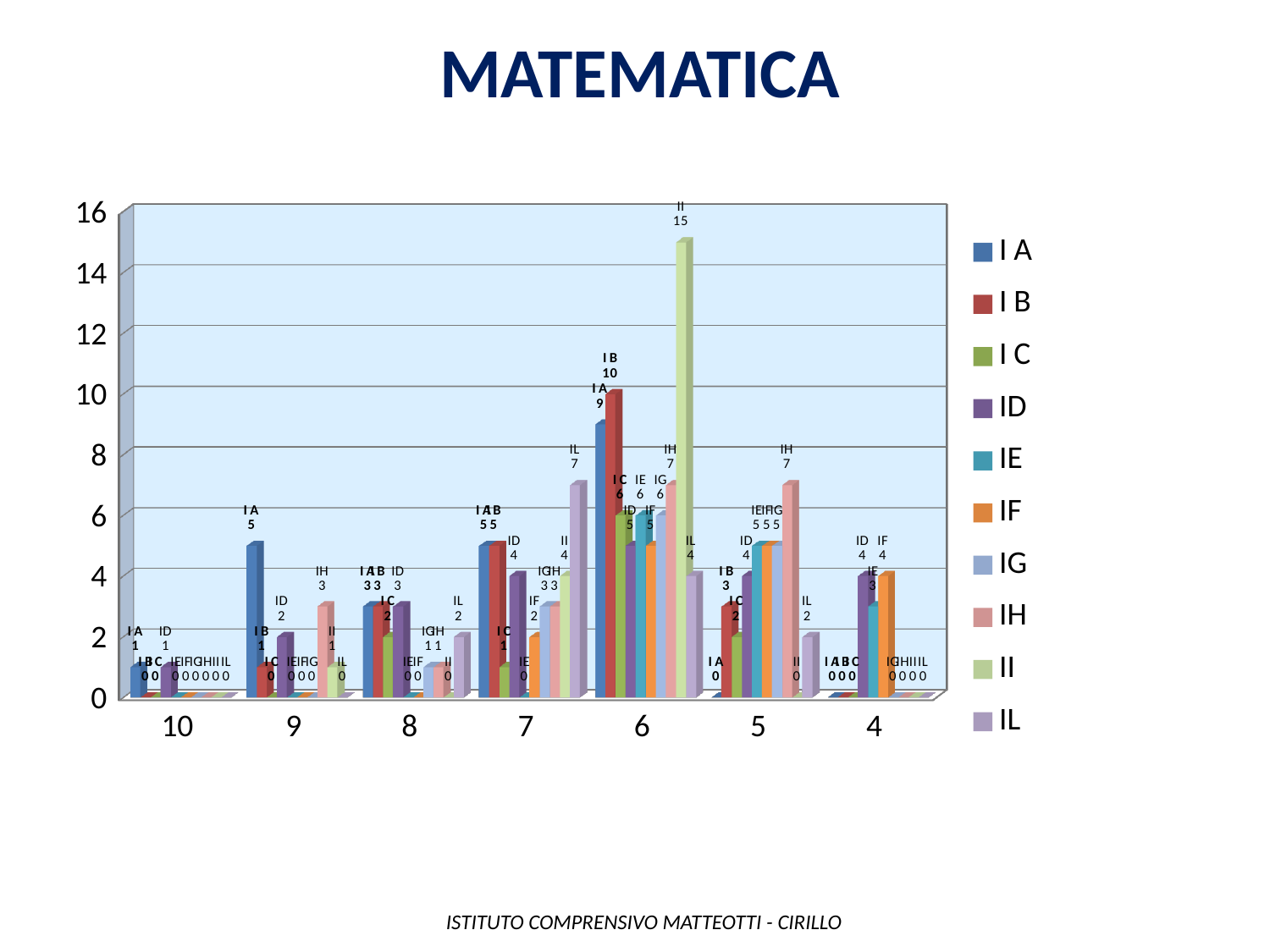
What kind of chart is shown on the slide? bar chart What is the value for series I A in category 9? 5 What is the difference between the values of I B and I A in category 6? 1 What is the value for series I B in category 6? 10 What is the value for series IH in category 5? 7 Is the value for series II in category 6 greater or less than 14? greater What is the value for series II in category 6? 15 How many categories are shown on the x axis? 7 How many series does the legend list? 10 Which series has the highest value in category 6? II In category 7, which is larger: the value for IL or the value for II? IL What is the title of the chart? MATEMATICA